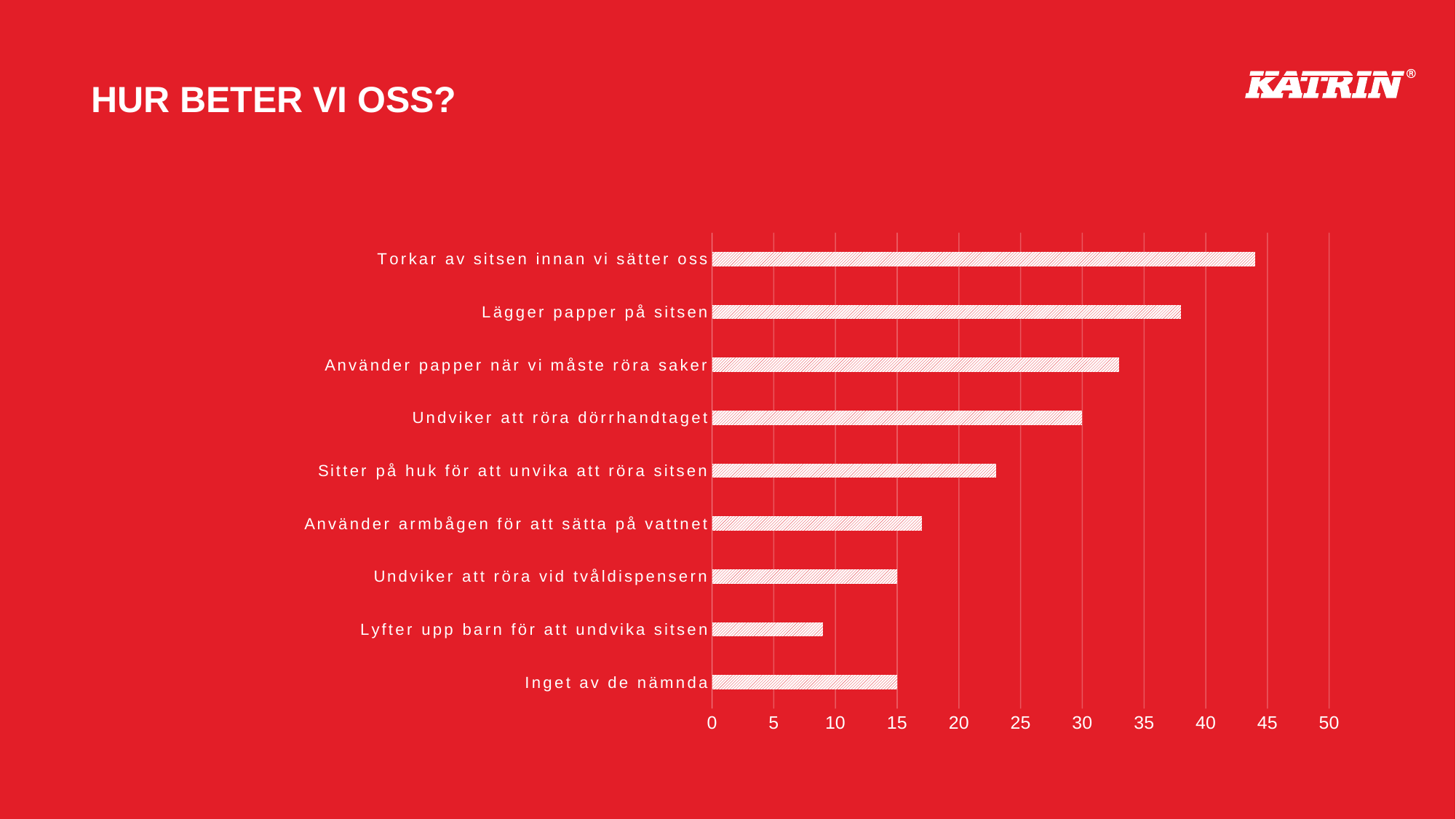
Which category has the highest value? Torkar av sitsen innan vi sätter oss How many categories are plotted in the chart? 9 Which category has the lowest value? Lyfter upp barn för att undvika sitsen Is the value for 'Lyfter upp barn för att undvika sitsen' greater or less than 10? less What is the title of the slide containing the chart? HUR BETER VI OSS? Is the value for 'Lägger papper på sitsen' greater or less than 40? less Is the value for 'Sitter på huk för att unvika att röra sitsen' greater or less than 20? greater Which is larger: the value for 'Lägger papper på sitsen' or for 'Använder papper när vi måste röra saker'? Lägger papper på sitsen Which is larger: the value for 'Undviker att röra dörrhandtaget' or for 'Lyfter upp barn för att undvika sitsen'? Undviker att röra dörrhandtaget What kind of chart is shown on the slide? bar chart